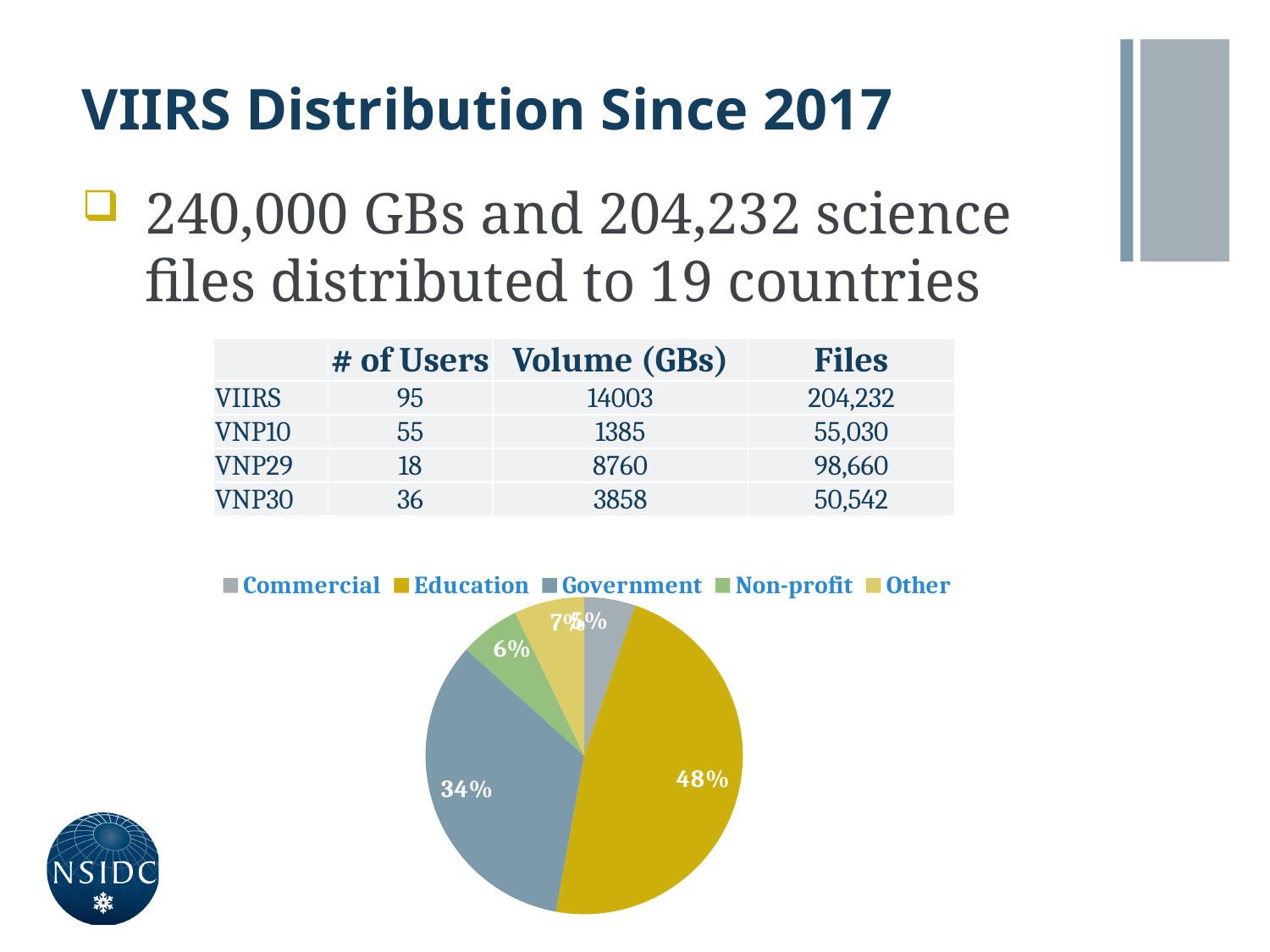
What kind of chart is shown on the slide? pie chart What is the difference between the Education and Government shares in the pie chart? 14% How many categories does the pie chart's legend list? 5 What share of the pie chart is Government? 34% Which slice is larger in the pie chart, Education or Government? Education What share of the pie chart is Non-profit? 6% What colour is the Education slice in the pie chart? gold Which slice is larger in the pie chart, Government or Non-profit? Government Which category has the largest slice of the pie chart? Education What are the legend entries of the pie chart, in order? Commercial, Education, Government, Non-profit, Other What is the difference between the Government and Non-profit shares in the pie chart? 28% What share of the pie chart is Education? 48%